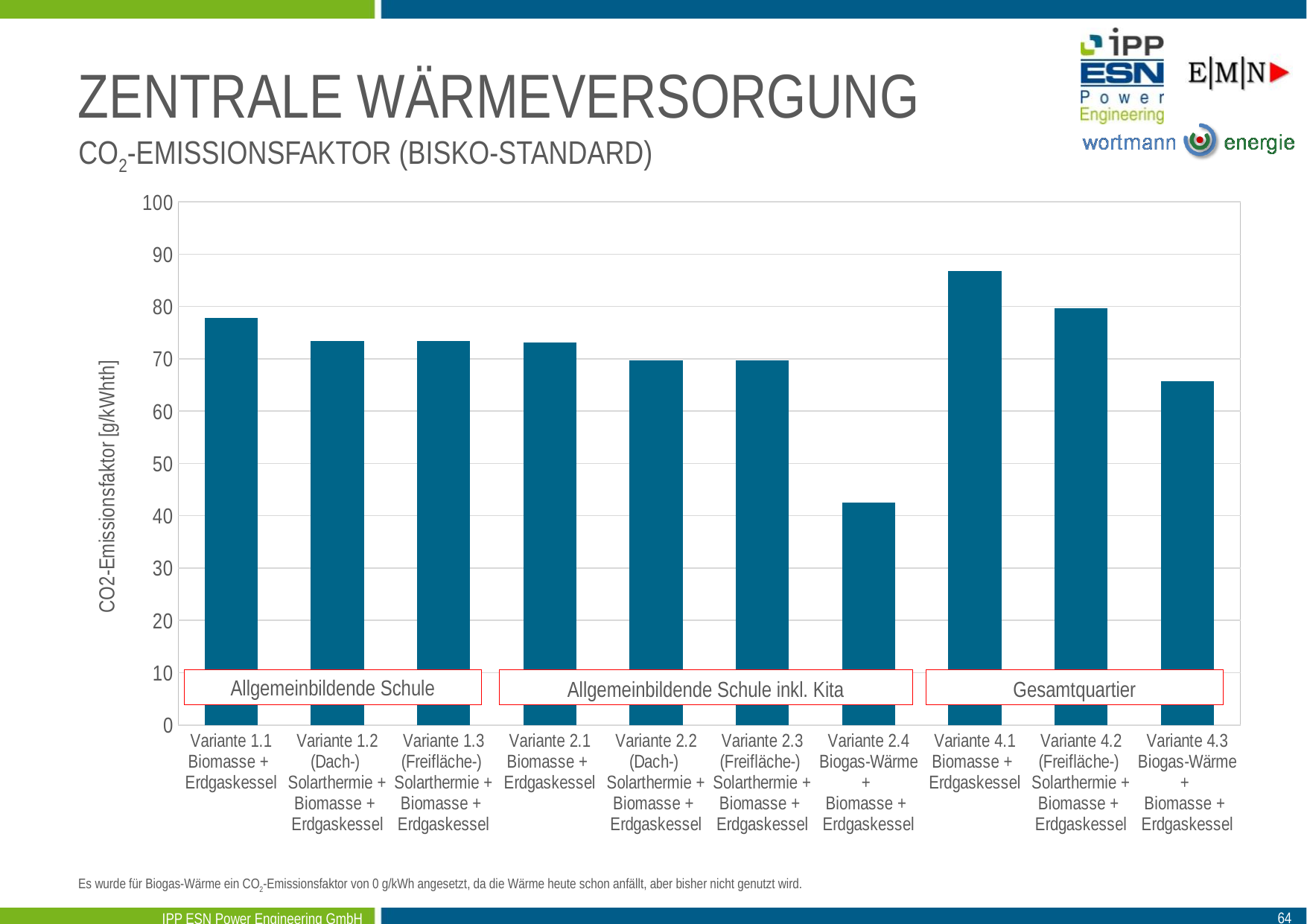
Is the value for Variante 2.4 greater or less than 50? less What kind of chart is shown on the slide? bar chart How many variants (bars) are plotted in the chart? 10 Which has the higher CO2-Emissionsfaktor, Variante 2.4 or Variante 4.3? Variante 4.3 Is the value for Variante 1.1 greater or less than 70? greater Is the value for Variante 4.1 greater or less than 80? greater Which variant has the highest CO2-Emissionsfaktor? Variante 4.1 Which group label is shown above the bars for Variante 4.1 to 4.3? Gesamtquartier Which variant has the lowest CO2-Emissionsfaktor? Variante 2.4 Which has the higher CO2-Emissionsfaktor, Variante 1.1 or Variante 2.1? Variante 1.1 What is the label of the y-axis of the chart? CO2-Emissionsfaktor [g/kWhth]